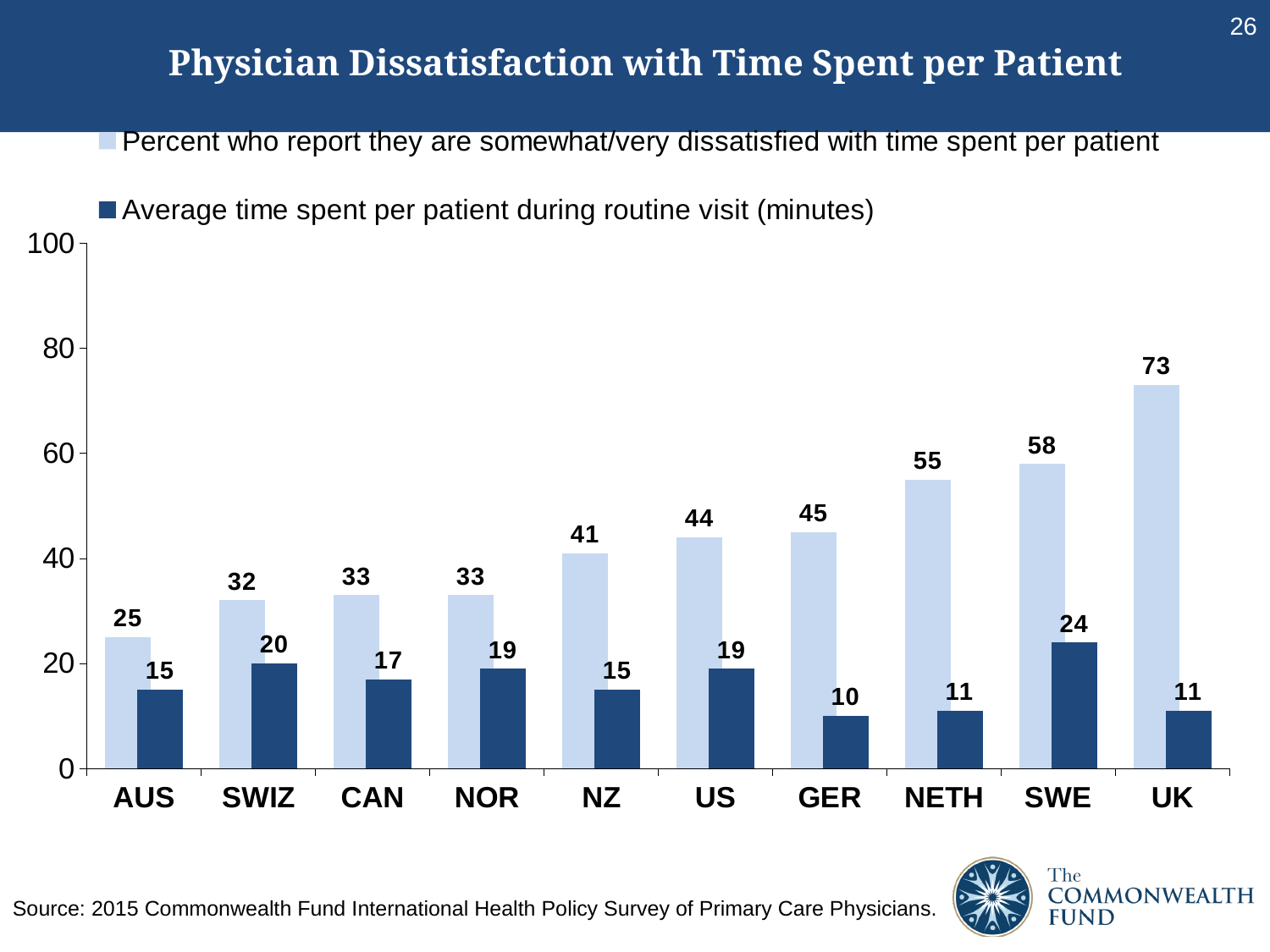
Is the percent dissatisfied in the Netherlands greater or less than 40? greater Which is larger: the percent dissatisfied in Germany or in the US? Germany What is the average time spent per patient during a routine visit in Sweden (minutes)? 24 What kind of chart is shown on the slide? Bar chart How many series does the legend list? 2 What is the difference between the percent dissatisfied in the UK and in Australia? 48 What is the title of the chart? Physician Dissatisfaction with Time Spent per Patient Does the percent dissatisfied with time spent per patient rise or fall from AUS to UK along the x axis? Rise Which country has the highest percent of physicians dissatisfied with time spent per patient? UK How many countries are shown on the x axis? 10 Which country has the lowest average time spent per patient during a routine visit? GER What percent of physicians in the UK report they are somewhat/very dissatisfied with time spent per patient? 73